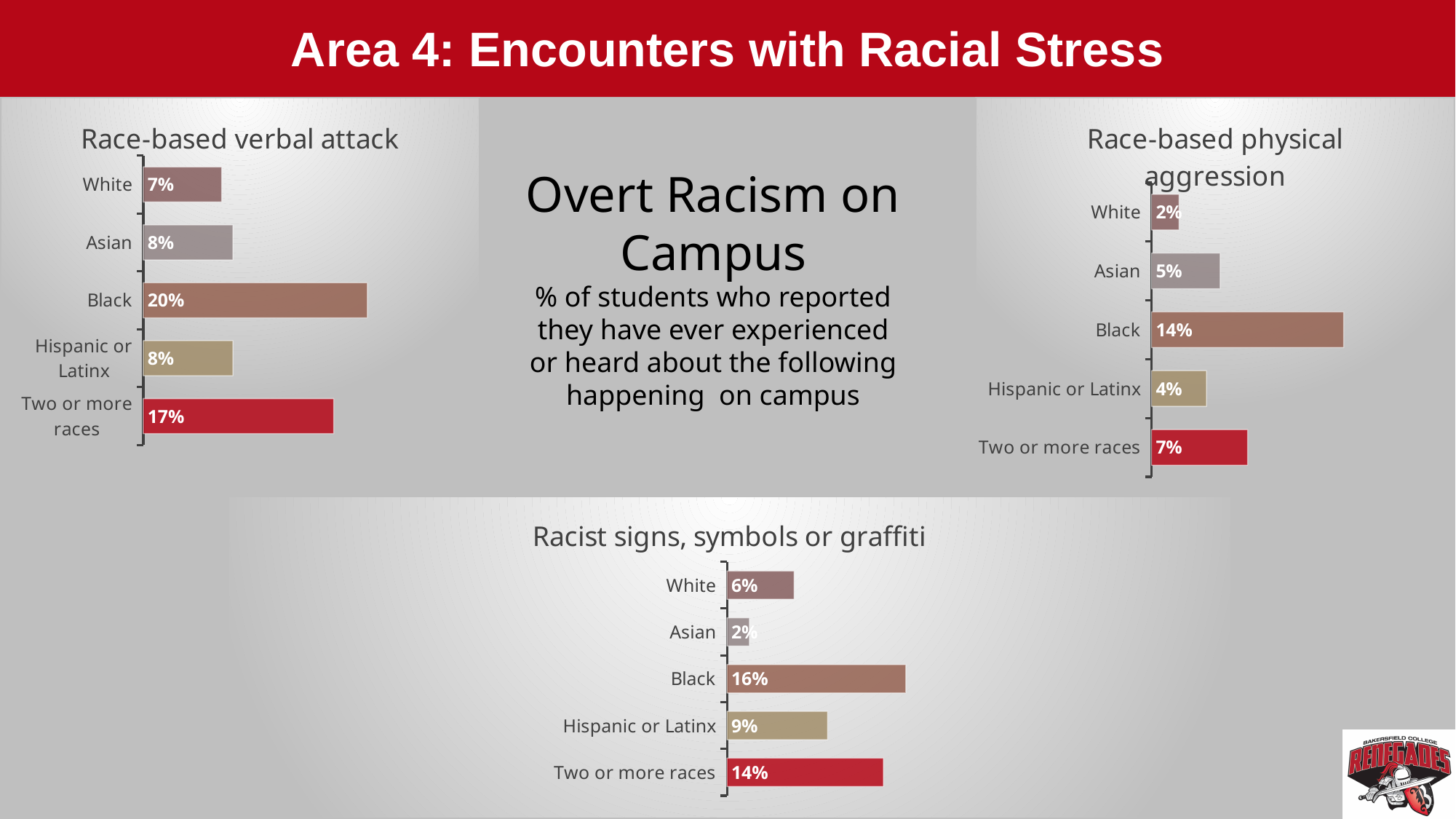
In the 'Racist signs, symbols or graffiti' chart, what is the difference between the values for Black and Hispanic or Latinx? 7% In the 'Racist signs, symbols or graffiti' chart, what is the value for Asian students? 2% What type of chart is the 'Race-based verbal attack' chart? Bar chart In the 'Racist signs, symbols or graffiti' chart, which category has the lowest value? Asian In the 'Race-based physical aggression' chart, which category has the highest value? Black In the 'Race-based verbal attack' chart, what is the value for Black students? 20% In the 'Race-based physical aggression' chart, which is larger, the value for Asian or the value for Two or more races? Two or more races How many categories are shown in the 'Racist signs, symbols or graffiti' chart? 5 In the 'Race-based verbal attack' chart, which category has the lowest value? White In the 'Race-based verbal attack' chart, what is the difference between the values for Black and Two or more races? 3% In the 'Race-based physical aggression' chart, what is the value for Hispanic or Latinx students? 4% How many charts are shown on the slide? 3